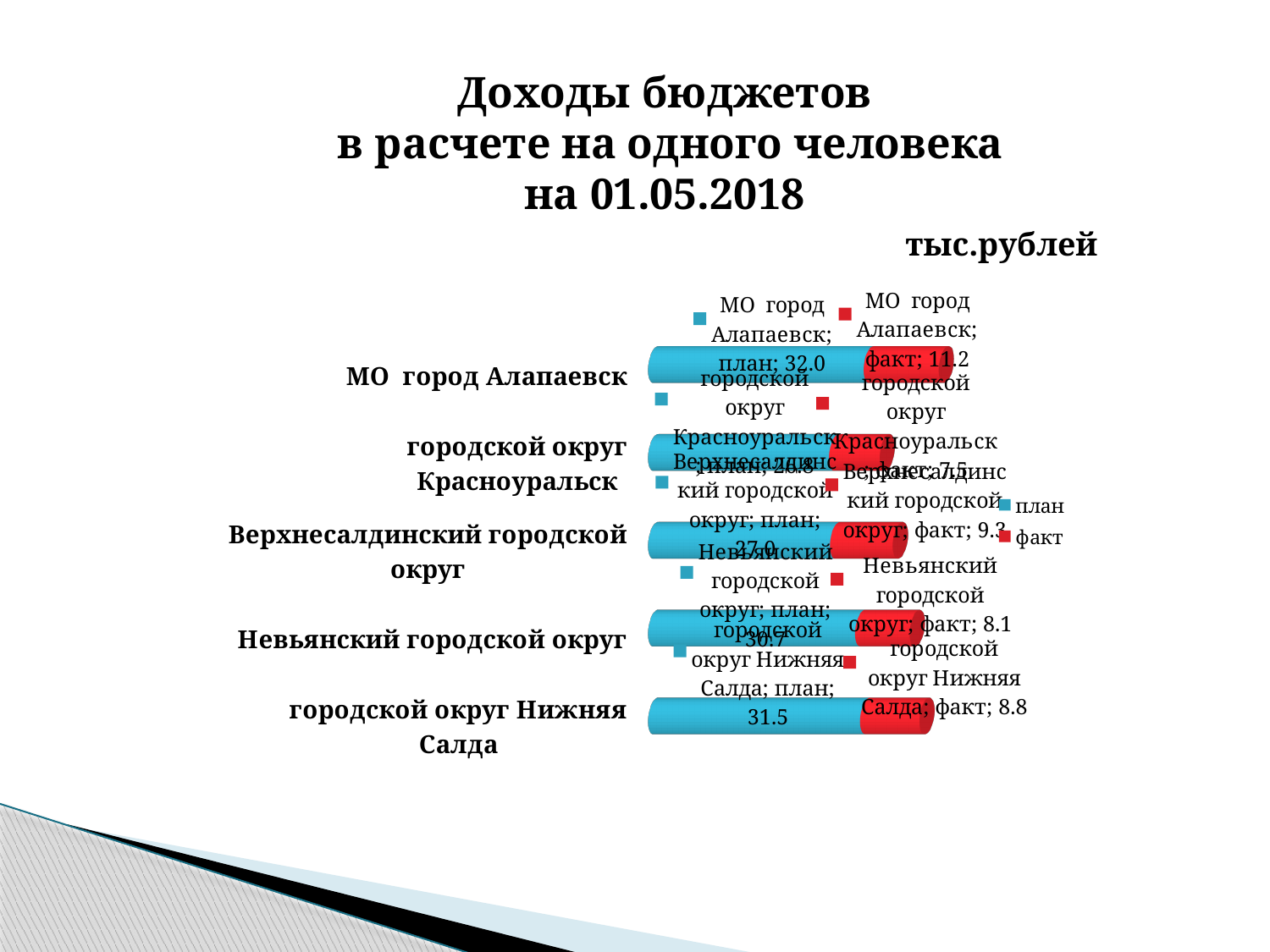
How many series does the legend list? 2 What kind of chart is shown on the slide? bar chart What is the факт value for Невьянский городской округ? 8.1 How many municipalities (categories) are shown in the chart? 5 What is the difference between the план and факт values for МО город Алапаевск? 20.8 What is the план value for городской округ Нижняя Салда? 31.5 Which municipality has the lowest факт value? городской округ Красноуральск What is the факт value for МО город Алапаевск? 11.2 What is the факт value for городской округ Нижняя Салда? 8.8 What is the план value for МО город Алапаевск? 32.0 Which municipality has the highest факт value? МО город Алапаевск Which colour represents the план series in the chart? blue